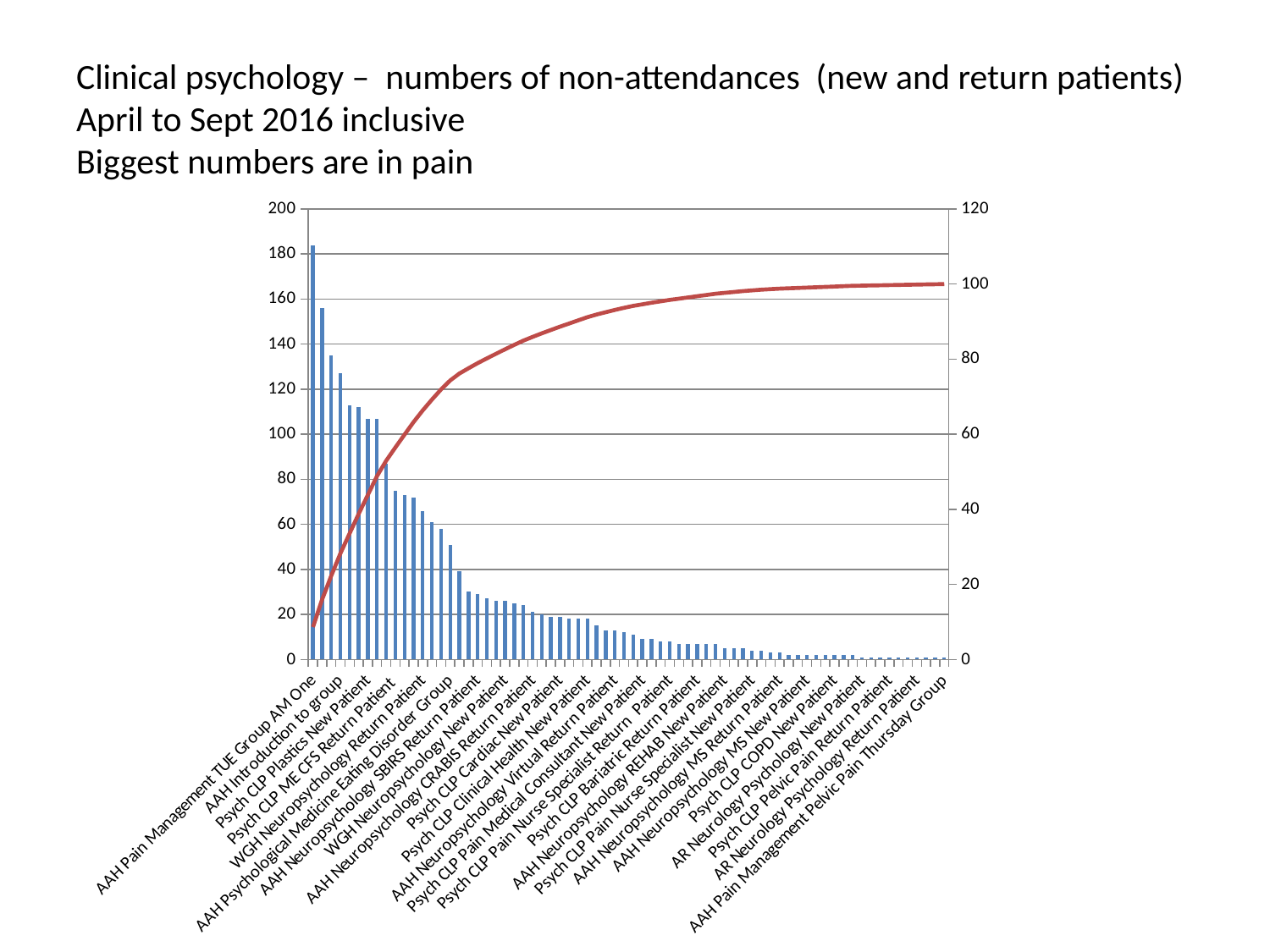
Do the bar values rise or fall from left to right along the x axis? Fall Is the value for AAH Pain Management Pelvic Pain Thursday Group greater or less than 20? less What value on the right-hand axis does the red line reach at the far right of the chart? 100 Which category has the highest number of non-attendances? AAH Pain Management TUE Group AM One What kind of chart is shown on the slide? A bar chart with a cumulative line Is the value for AAH Pain Management TUE Group AM One greater or less than 160? greater Which is larger, the value for AAH Pain Management TUE Group AM One or the value for AAH Pain Management Pelvic Pain Thursday Group? AAH Pain Management TUE Group AM One What is the highest tick value shown on the left-hand vertical axis? 200 What colour are the bars in the chart? Blue Does the red line rise or fall from left to right? Rise